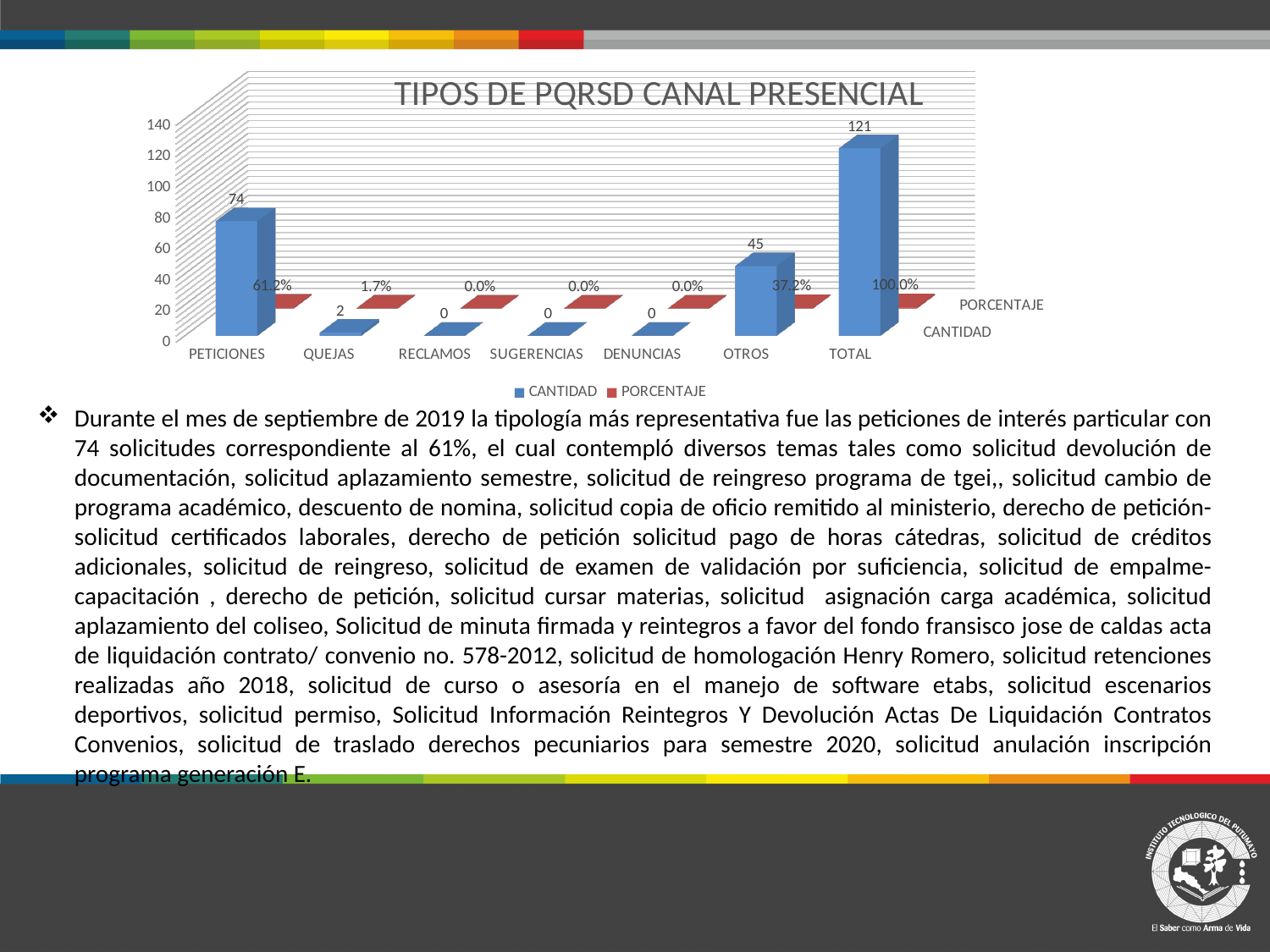
What is the CANTIDAD value for QUEJAS? 2 What is the PORCENTAJE value for PETICIONES? 61.2% What is the difference in CANTIDAD between PETICIONES and OTROS? 29 How many categories are shown on the x axis? 7 What is the title of the chart? TIPOS DE PQRSD CANAL PRESENCIAL What is the CANTIDAD value for TOTAL? 121 What is the PORCENTAJE value for OTROS? 37.2% Excluding TOTAL, which category has the highest CANTIDAD? PETICIONES Which has a larger CANTIDAD, OTROS or QUEJAS? OTROS What kind of chart is shown on the slide? Bar chart What is the CANTIDAD value for PETICIONES? 74 How many series does the legend list? 2